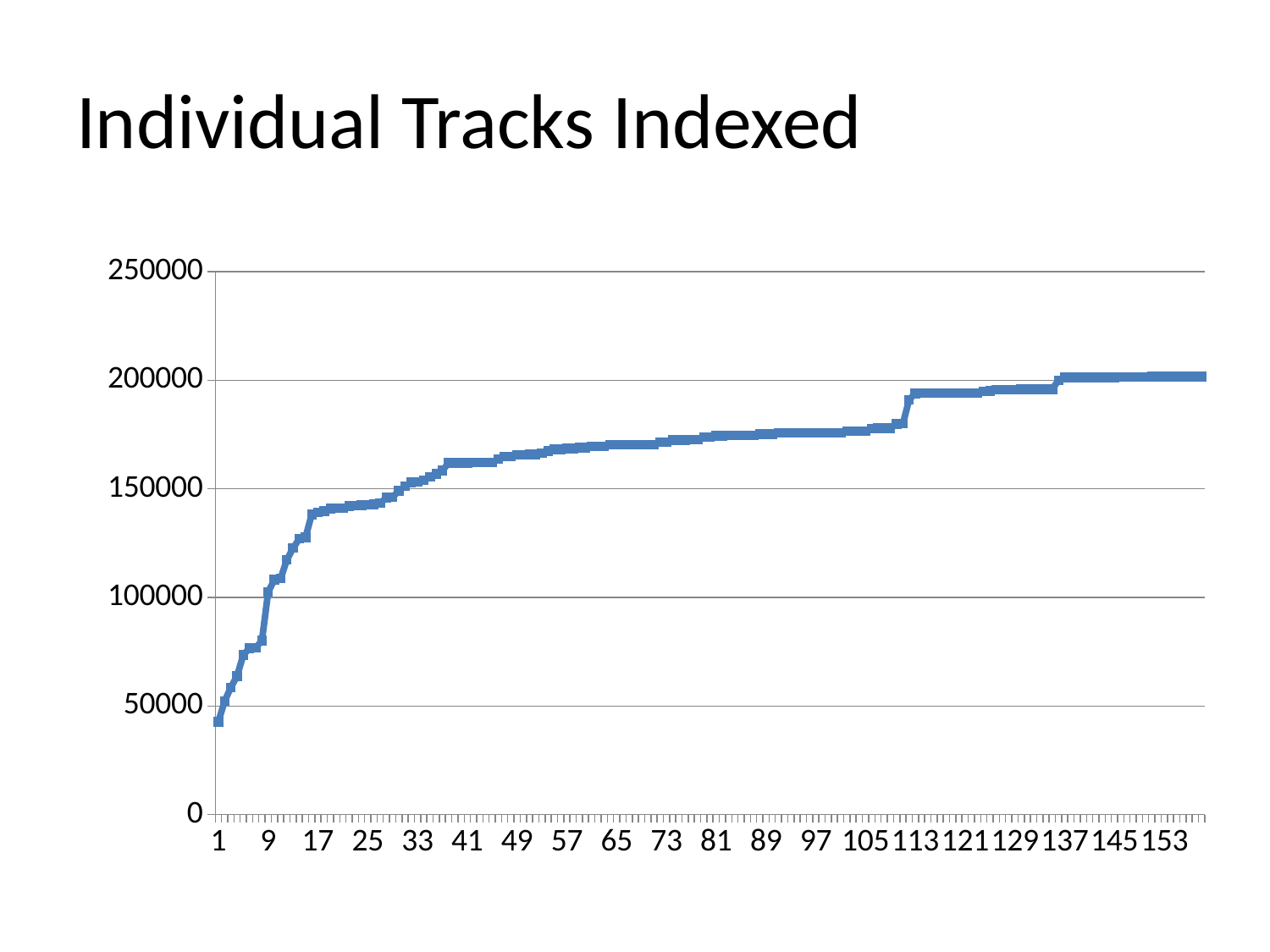
What is the highest value shown on the y axis? 250000 Is the value at x = 65 greater or less than 200000? less What kind of chart is shown on the slide? line chart Do the values rise or fall as you move along the x axis from 1 to 153? rise Is the value at x = 113 greater or less than 150000? greater Which is larger, the value at x = 9 or the value at x = 97? x = 97 Is the value at x = 17 greater or less than 150000? less What is the title of the chart? Individual Tracks Indexed